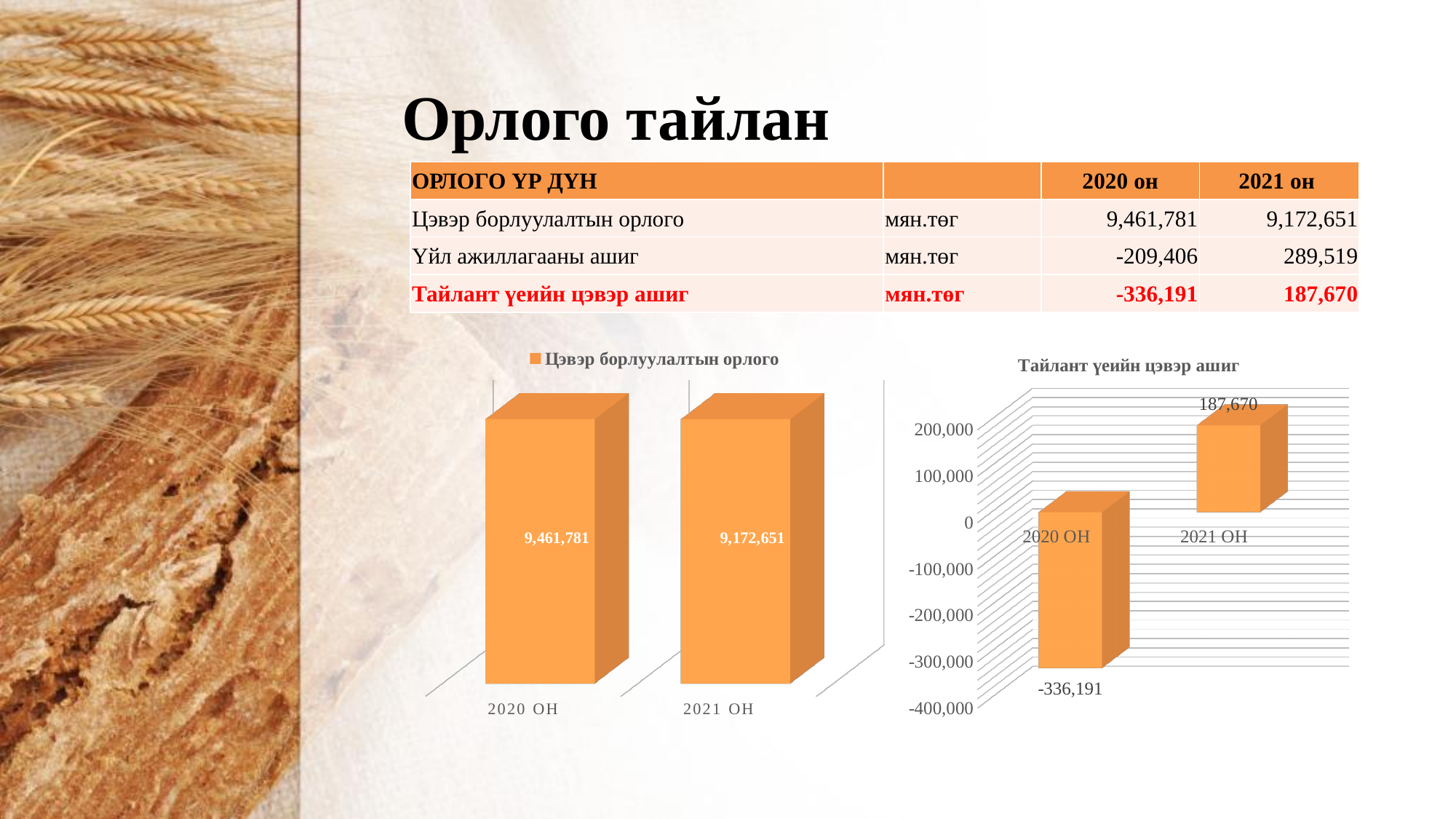
In the right chart (Тайлант үеийн цэвэр ашиг), which year has the lowest value? 2020 ОН In the right chart (Тайлант үеийн цэвэр ашиг), is the value for 2020 ОН greater or less than -300,000? less How many categories does the left chart (Цэвэр борлуулалтын орлого) show? 2 In the right chart (Тайлант үеийн цэвэр ашиг), by how much does the 2021 ОН value exceed the 2020 ОН value? 523,861 In the right chart (Тайлант үеийн цэвэр ашиг), do the values rise or fall from 2020 ОН to 2021 ОН? rise What kind of chart is the right chart (Тайлант үеийн цэвэр ашиг)? bar chart In the right chart (Тайлант үеийн цэвэр ашиг), what is the value for 2020 ОН? -336,191 In the left chart (Цэвэр борлуулалтын орлого), what is the difference between the 2020 ОН and 2021 ОН values? 289,130 In the right chart (Тайлант үеийн цэвэр ашиг), what is the value for 2021 ОН? 187,670 In the left chart (Цэвэр борлуулалтын орлого), what is the value for 2021 ОН? 9,172,651 In the left chart (Цэвэр борлуулалтын орлого), which year has the higher value? 2020 ОН In the left chart (Цэвэр борлуулалтын орлого), what is the value for 2020 ОН? 9,461,781